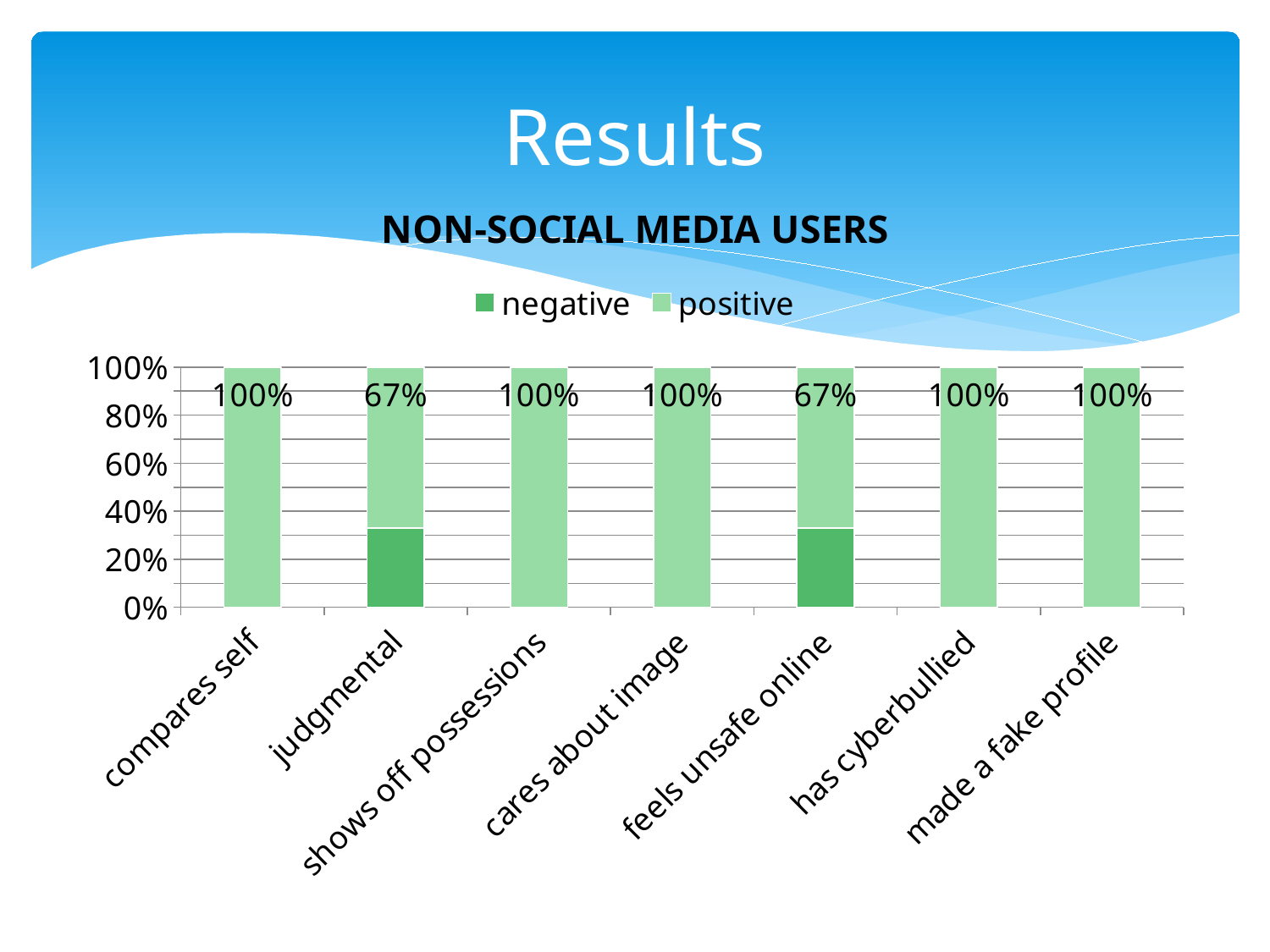
What kind of chart is shown on the slide? Stacked bar chart How many categories are shown on the x axis? 7 Is the positive value for 'has cyberbullied' larger than the positive value for 'feels unsafe online'? Yes Is the negative value for 'feels unsafe online' greater or less than 20%? greater How many series does the legend list? 2 What is the positive value for 'made a fake profile'? 100% What is the positive value for 'feels unsafe online'? 67% Which categories have the lowest positive value? judgmental and feels unsafe online What is the positive value for 'compares self'? 100% What is the difference between the positive value for 'compares self' and the positive value for 'judgmental'? 33% What is the positive value for 'judgmental'? 67% Is the negative value for 'judgmental' greater or less than 40%? less